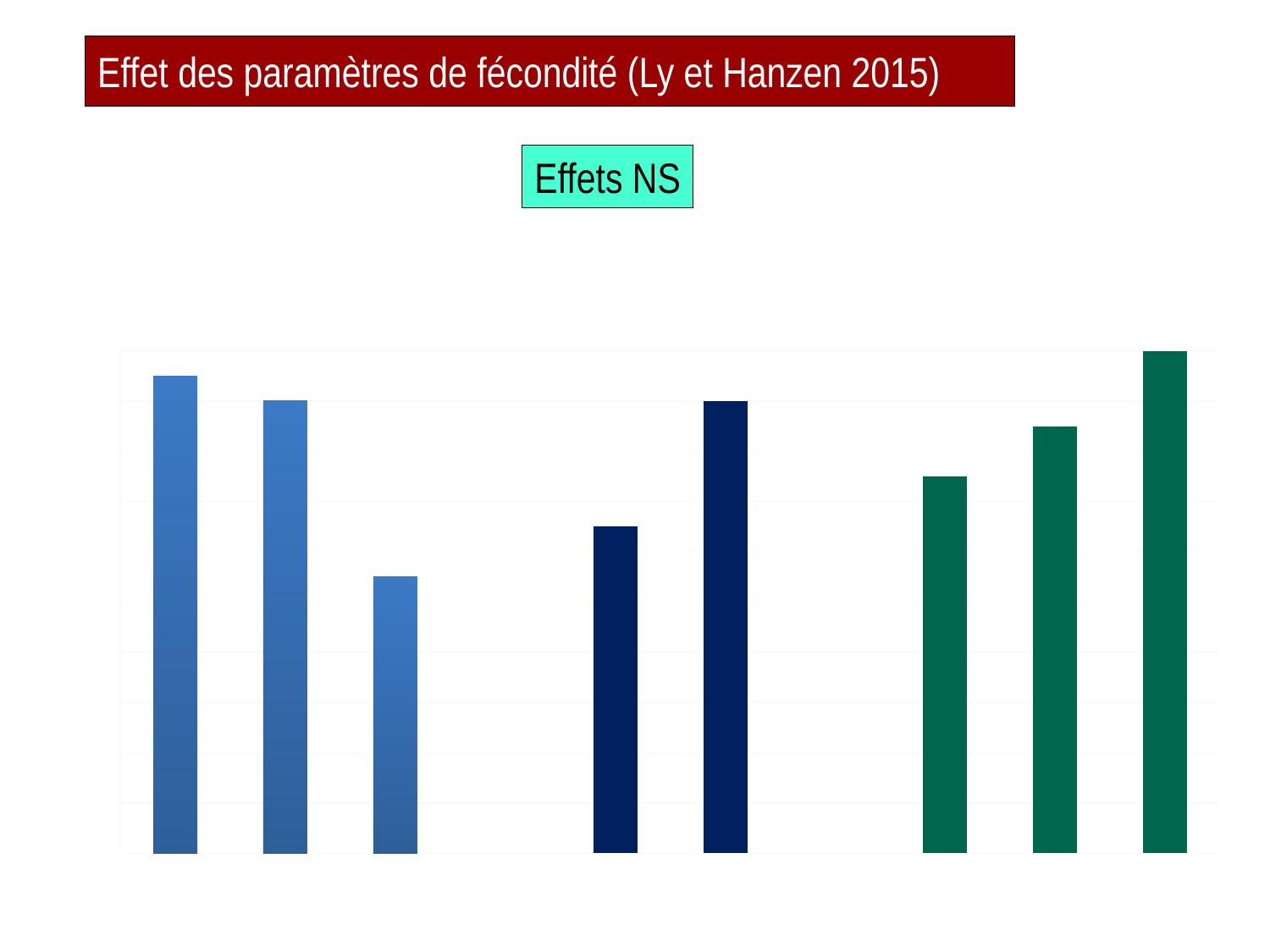
What kind of chart is shown on the slide? bar chart Among the three light blue bars on the left, do the values rise or fall from left to right? fall Is the first bar from the left taller or shorter than the second bar? taller How many bars are coloured green in the chart? 3 Among the three green bars on the right, do the values rise or fall from left to right? rise Is the fourth bar from the left taller or shorter than the fifth bar? shorter How many bars are coloured dark navy in the chart? 2 How many bars are plotted in the chart? 8 Which bar is the tallest in the chart, counting from the left? the eighth (rightmost) bar How many different bar colours are used in the chart? 3 Which bar is the shortest in the chart, counting from the left? the third bar What is the title shown in the red banner at the top of the slide? Effet des paramètres de fécondité (Ly et Hanzen 2015)